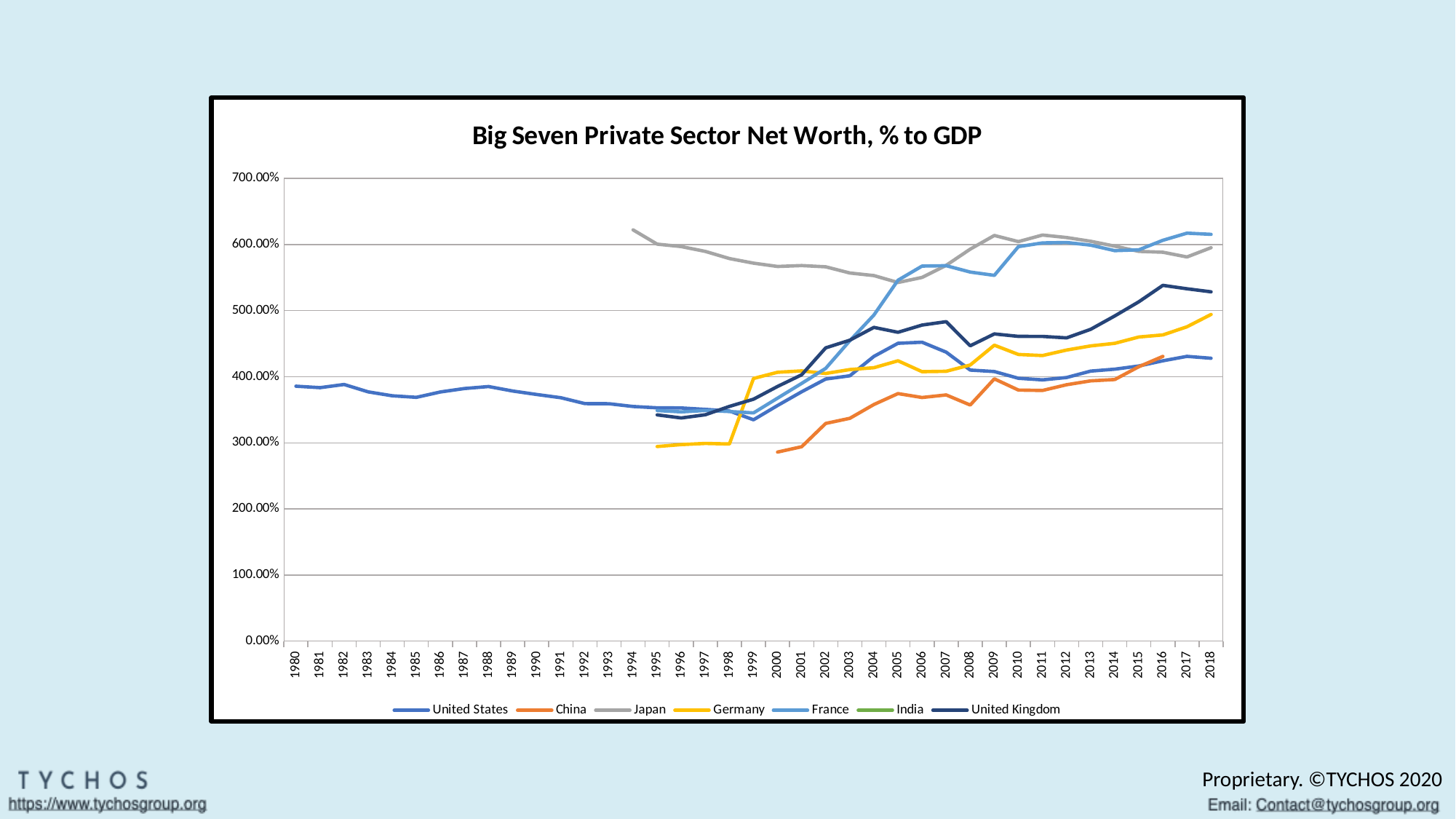
Which series has the highest value in 1994? Japan Is the value for China in 2000 greater or less than 300.00%? less What is the title of the chart? Big Seven Private Sector Net Worth, % to GDP In 2010, which is higher: Germany or China? Germany Is the value for the United States in 1980 greater or less than 400.00%? less How many series does the legend list? 7 Is the value for Japan in 1994 greater or less than 600.00%? greater Does the Japan line rise or fall from 1994 to 2005? Fall Which series has the lowest value in 2000? China What kind of chart is shown on the slide? Line chart How many years are shown along the x axis? 39